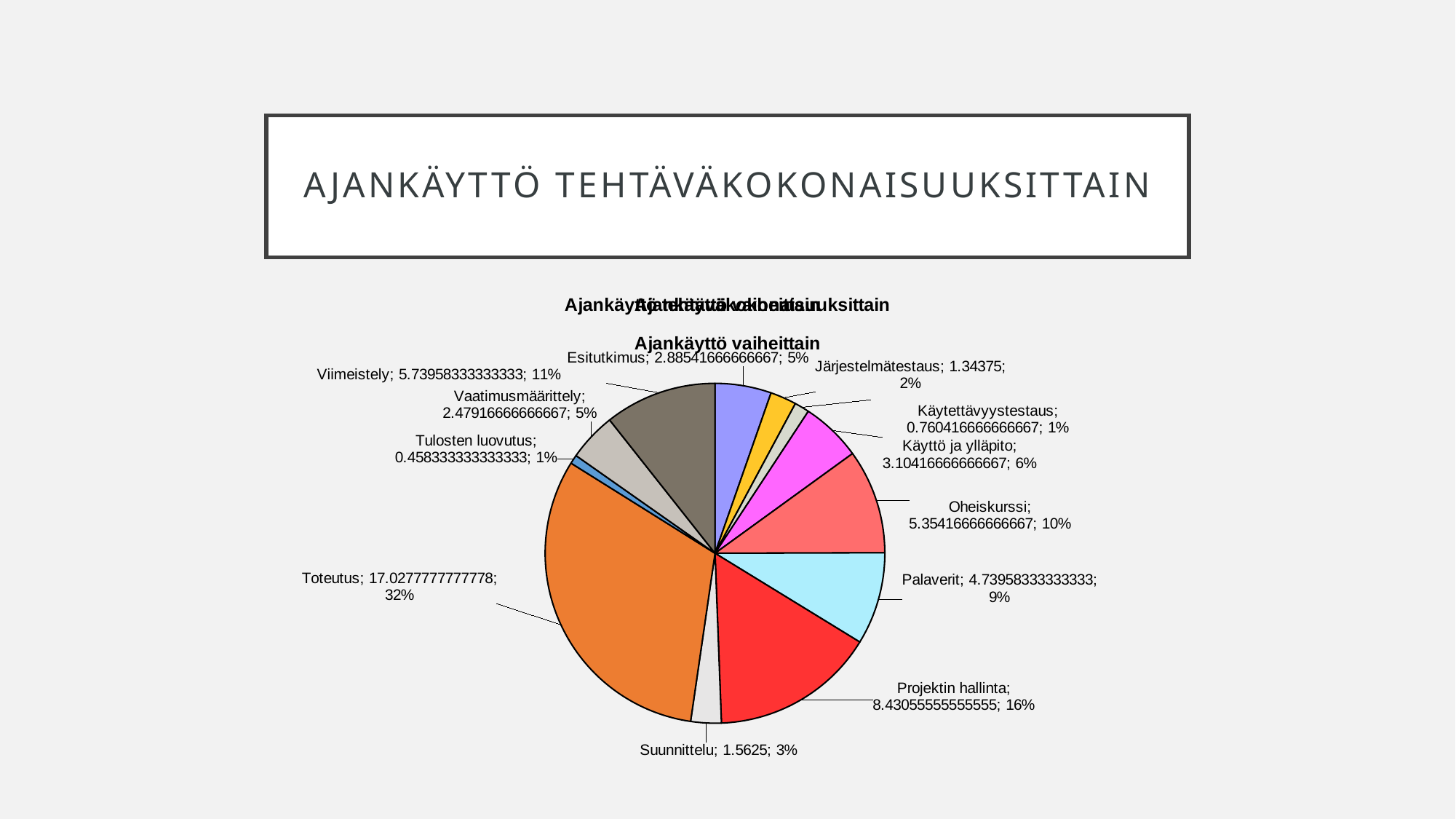
What share of the pie does Viimeistely represent? 11% What is the difference in percentage share between Toteutus and Projektin hallinta? 16% What is the difference between the values for Suunnittelu and Järjestelmätestaus? 0.21875 What is the value shown for Toteutus? 17.0277777777778 How many slices does the pie chart have? 12 What is the value shown for Suunnittelu? 1.5625 Which category has the smallest slice of the pie? Tulosten luovutus Which is larger, the value for Oheiskurssi or the value for Palaverit? Oheiskurssi What share of the pie does Projektin hallinta represent? 16% What is the value shown for Järjestelmätestaus? 1.34375 Which category has the largest slice of the pie? Toteutus What kind of chart is shown on the slide? pie chart